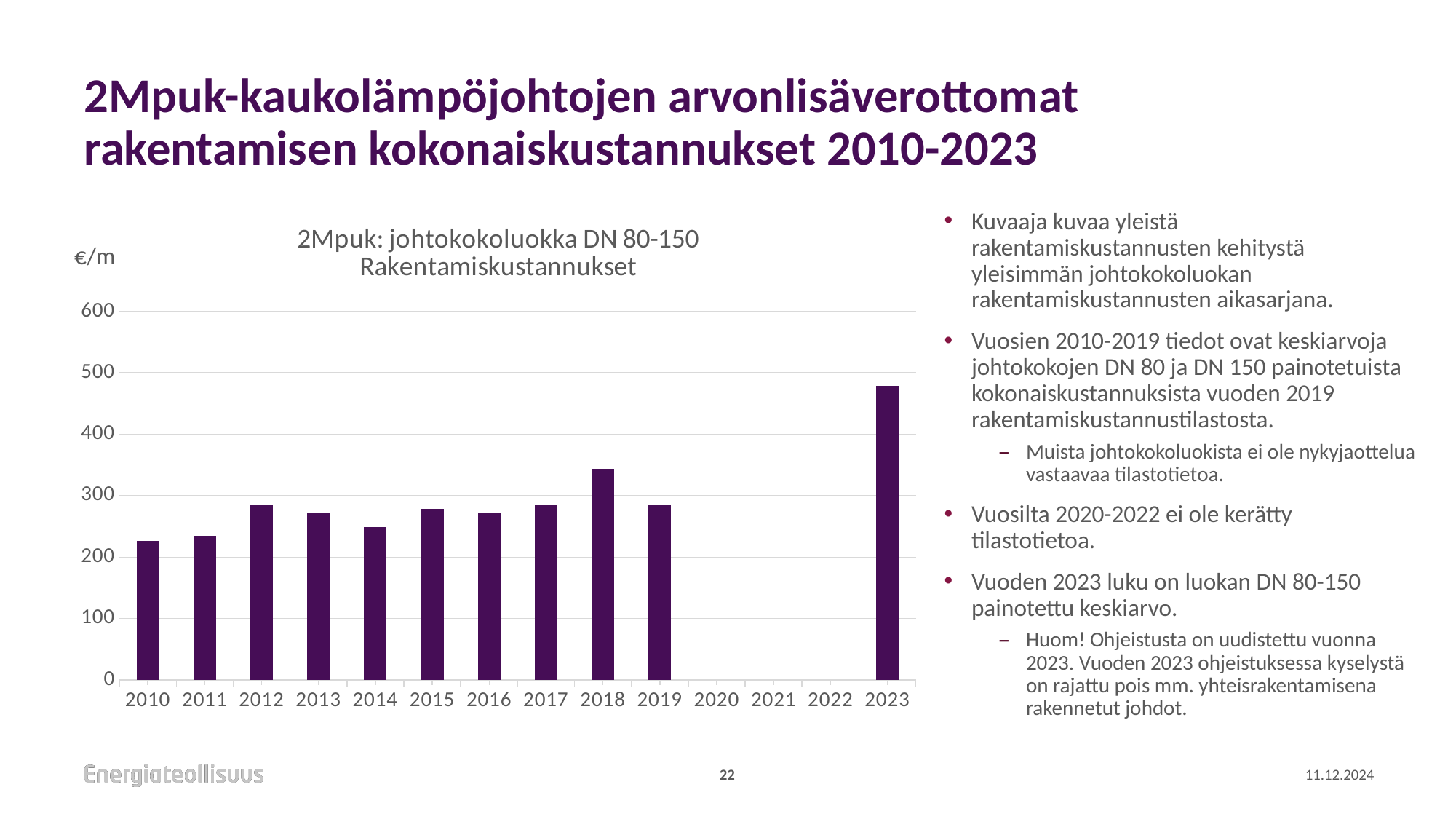
Which year has the highest construction cost in the chart? 2023 Is the value for 2018 greater or less than 300? greater What unit is shown on the y axis of the chart? €/m Is the value for 2023 greater or less than 400? greater What kind of chart is shown on the slide? bar chart How many years are labelled on the x axis of the chart? 14 Which is larger, the value for 2018 or the value for 2019? 2018 How many years on the x axis have no bar plotted? 3 What is the title of the chart? 2Mpuk: johtokokoluokka DN 80-150 Rakentamiskustannukset Is the value for 2014 greater or less than 200? greater Which is larger, the value for 2012 or the value for 2014? 2012